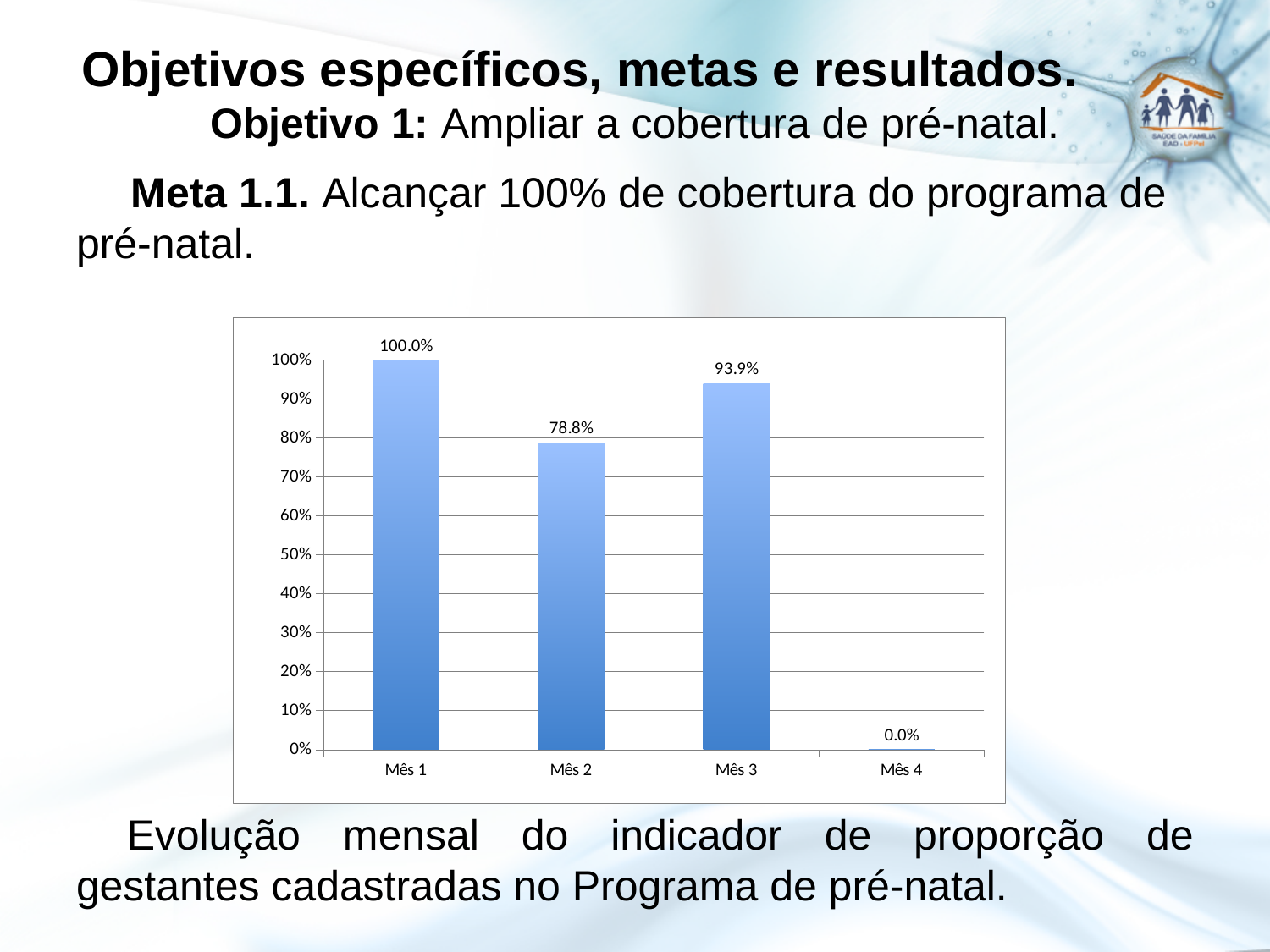
What is the value for Mês 1? 100.0% Which month has the highest value? Mês 1 What is the value for Mês 3? 93.9% What is the value for Mês 4? 0.0% What is the difference between the values for Mês 3 and Mês 2? 15.1% What is the value for Mês 2? 78.8% How many months are shown on the x axis? 4 What is the difference between the values for Mês 1 and Mês 2? 21.2% Is the value for Mês 2 greater or less than 80%? less What kind of chart is shown on the slide? bar chart Which is larger, the value for Mês 2 or the value for Mês 3? Mês 3 Which month has the lowest value? Mês 4